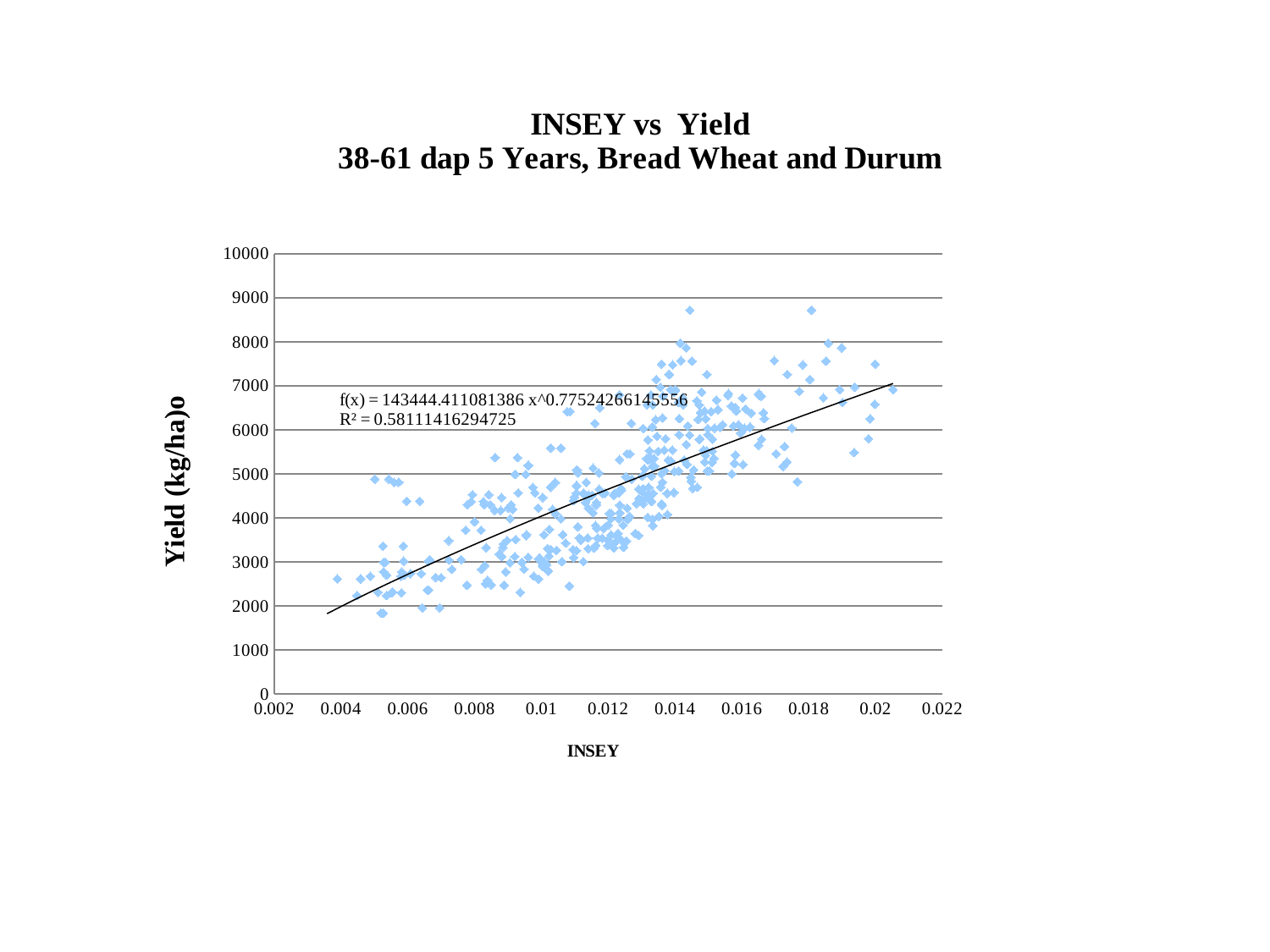
What is the maximum value shown on the y axis? 10000 What is the maximum value shown on the x axis? 0.022 What fitted equation f(x) is printed on the chart? f(x) = 143444.411081386 x^0.77524266145556 Is the yield of the lowest plotted point greater or less than 3000? less What kind of chart is shown on the slide? scatter chart What R² value is printed on the chart? R² = 0.58111416294725 Does the trend line slope upward or downward from left to right? upward What is the title of the chart? INSEY vs Yield 38-61 dap 5 Years, Bread Wheat and Durum Do the yield values generally rise or fall as INSEY increases along the x axis? rise What is the label of the y axis? Yield (kg/ha)o Is the yield of the highest plotted point greater or less than 9000? less Is the yield of the highest plotted point greater or less than 8000? greater